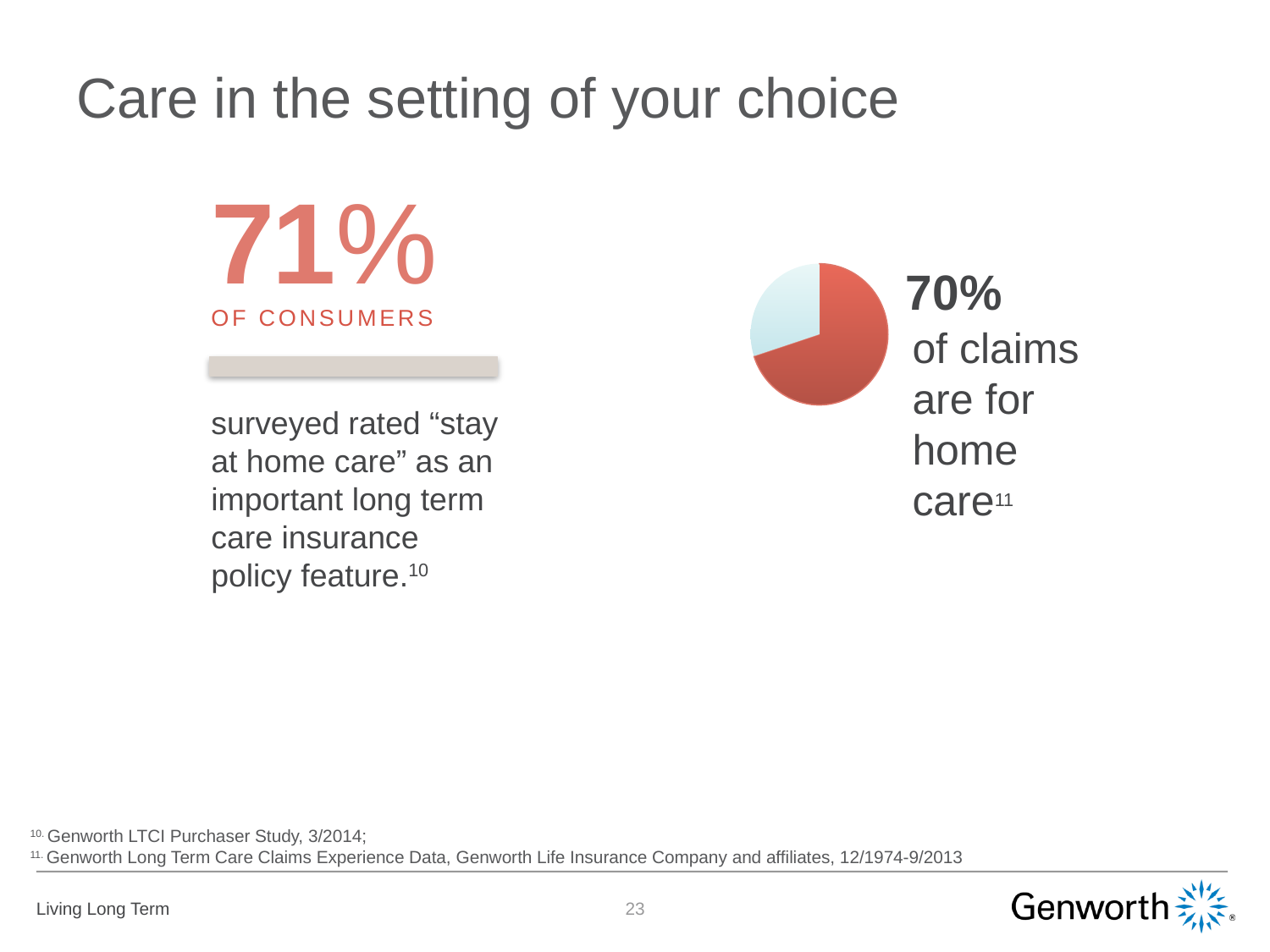
How many slices does the pie chart have? 2 According to the pie chart, what share of claims are for home care? 70% What kind of chart is shown on the slide? pie chart Does the pie chart's home care slice represent more or less than 60% of claims? more Which slice of the pie chart is larger, the red slice or the light blue slice? the red slice Is the home care slice of the pie chart greater or less than half of the pie? greater What colour is the slice of the pie chart representing home care claims? red